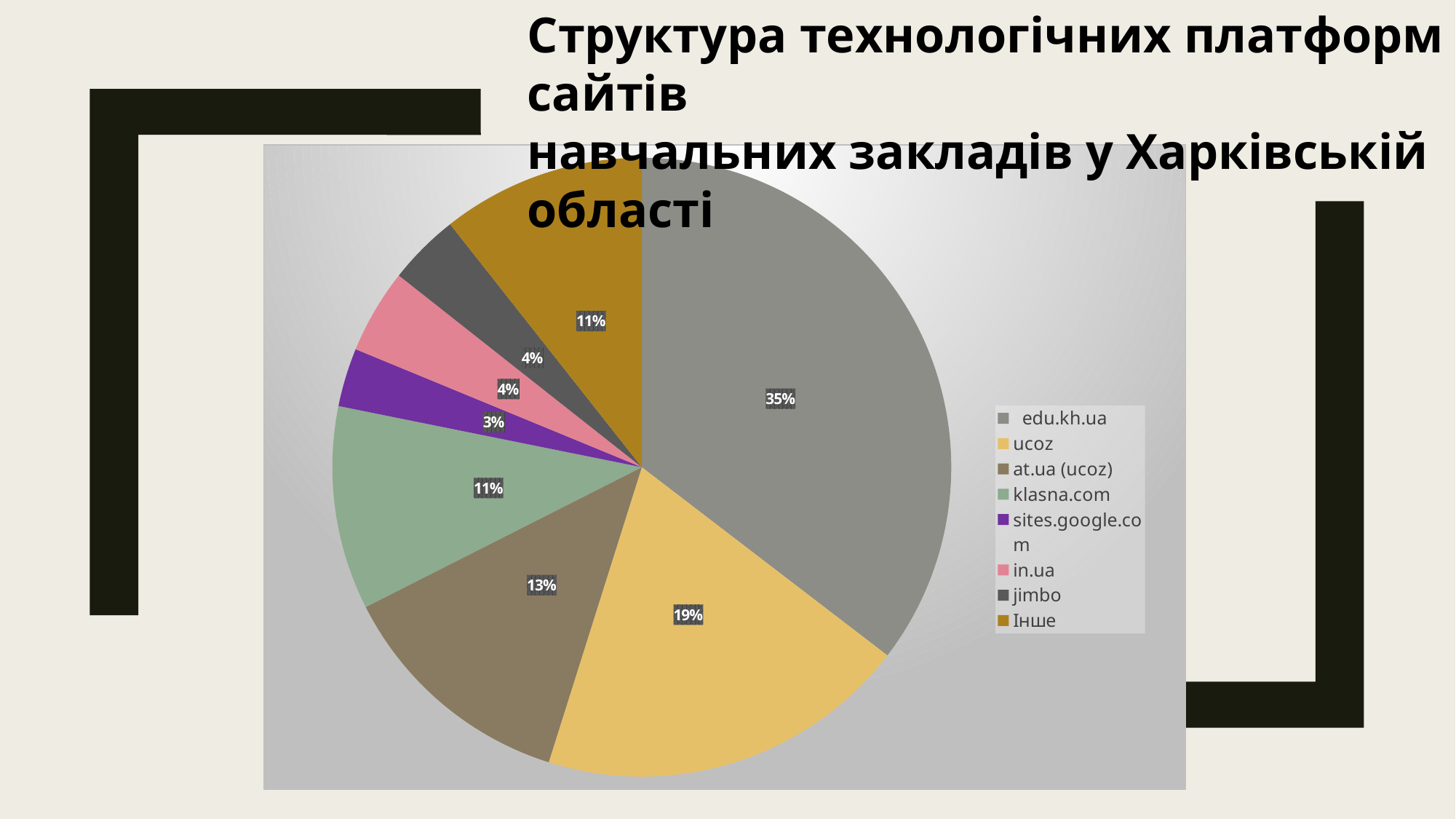
Which platform has the largest share of the pie? edu.kh.ua What share of the pie does at.ua (ucoz) have? 13% What share of the pie does sites.google.com have? 3% What share of the pie does edu.kh.ua have? 35% What is the difference in percentage points between edu.kh.ua and ucoz? 16 What share of the pie does ucoz have? 19% How many slices does the pie chart have? 8 What type of chart is shown on the slide? pie chart Which platform has the smallest share of the pie? sites.google.com What share of the pie does klasna.com have? 11% Which has a larger share, at.ua (ucoz) or klasna.com? at.ua (ucoz) What colour is the slice for in.ua? pink